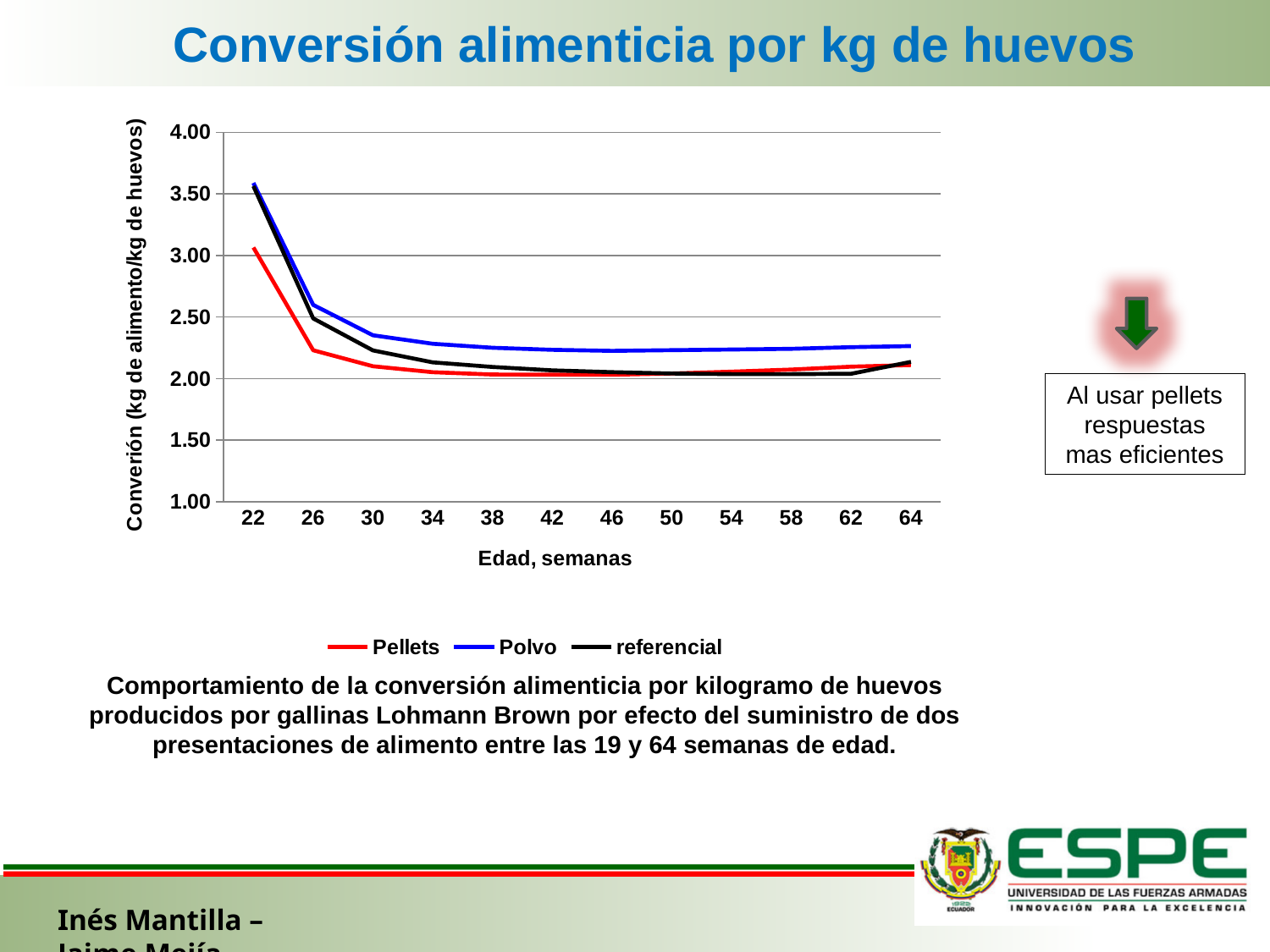
At week 22, which is larger, the value for Pellets or the value for Polvo? Polvo Is the value for Polvo at week 64 greater or less than 2.50? less Is the value for Polvo at week 22 greater or less than 3.50? greater What is the label of the x axis? Edad, semanas Does the Pellets series rise or fall from week 22 to week 46? fall How many series does the legend list? 3 What kind of chart is shown on the slide? line chart At week 50, which is larger, the value for Polvo or the value for Pellets? Polvo How many age points (weeks) are plotted along the x axis? 12 Which series has the lowest value at week 22? Pellets Which series has the highest value at week 46? Polvo Is the value for Pellets at week 26 greater or less than 2.50? less